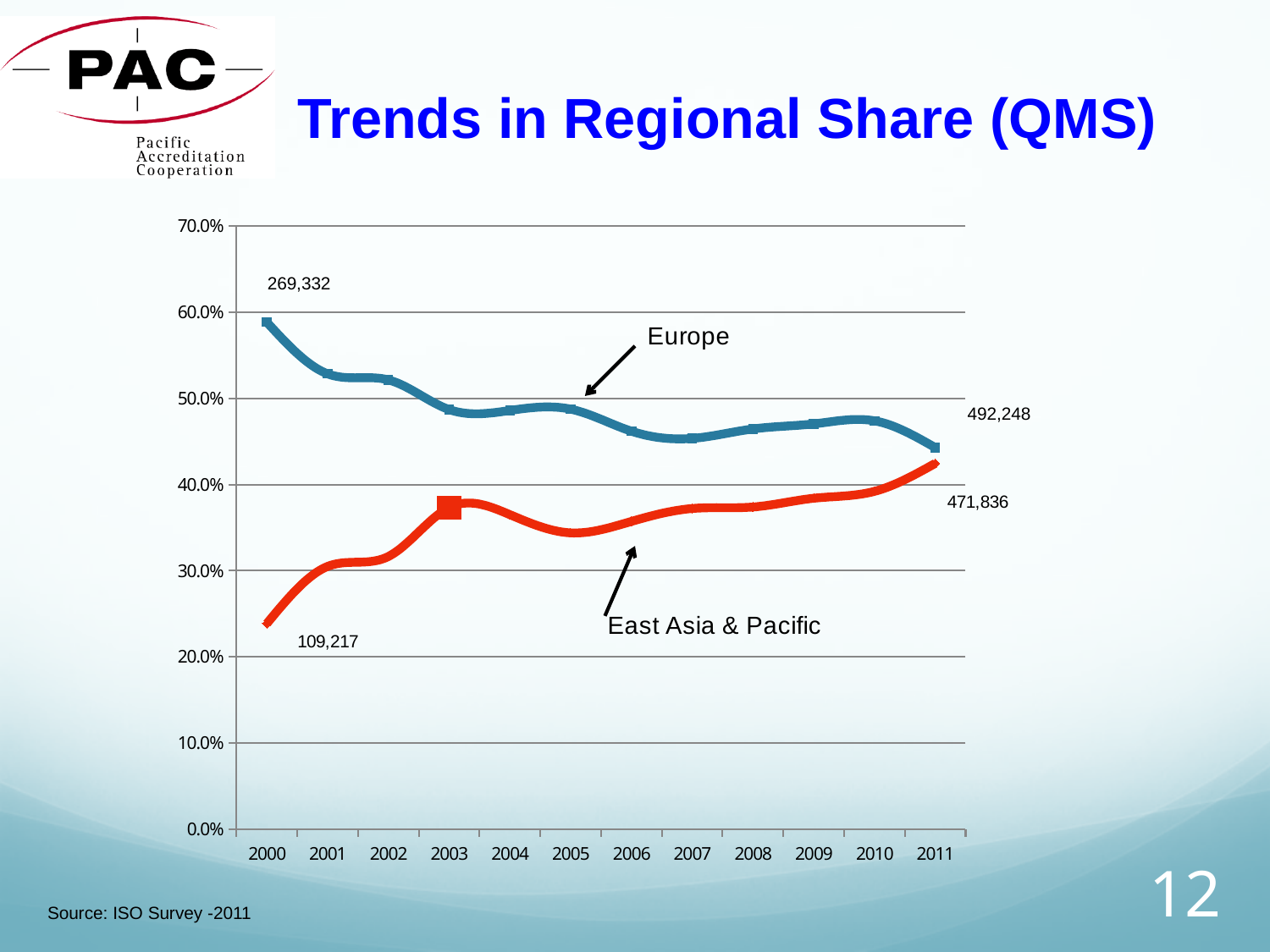
Is the East Asia & Pacific share in 2000 greater or less than 30.0%? less What value is labelled at the end of the Europe line in 2011? 492,248 What value is labelled at the end of the East Asia & Pacific line in 2011? 471,836 Does the Europe share rise or fall from 2000 to 2011? fall What value is labelled at the start of the Europe line in 2000? 269,332 How many years are shown along the x axis? 12 How many lines (series) are plotted on the chart? 2 What value is labelled at the start of the East Asia & Pacific line in 2000? 109,217 Is the Europe share in 2000 greater or less than 50.0%? greater What is the title of the chart? Trends in Regional Share (QMS) What kind of chart is shown on the slide? line chart In 2005, which region has the higher share, Europe or East Asia & Pacific? Europe